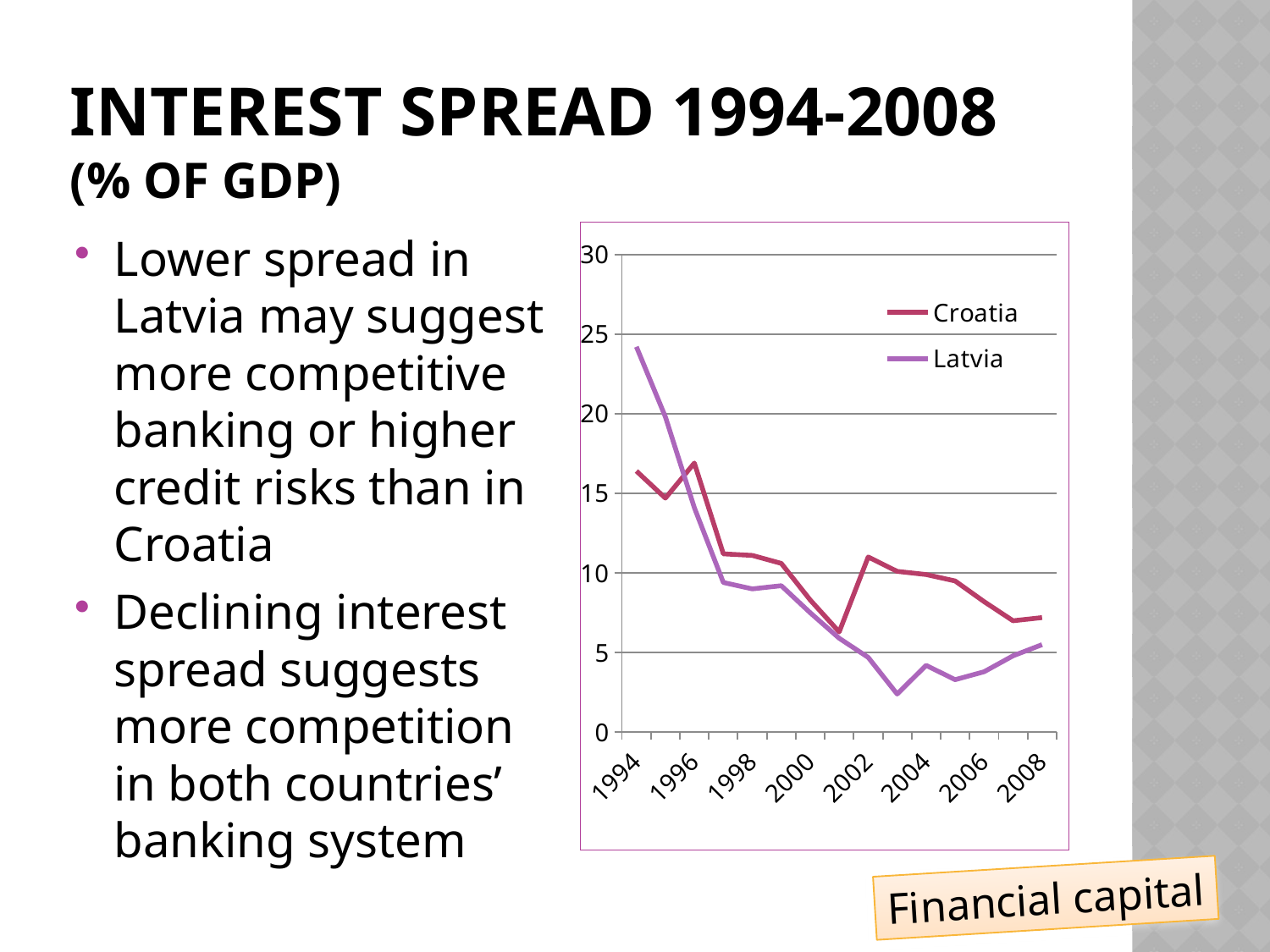
In 2008, which country has the higher interest spread, Croatia or Latvia? Croatia What kind of chart is shown on the slide? line chart How many series does the chart legend list? 2 Is the value for Latvia in 1994 greater or less than 20? greater Is the value for Croatia in 1994 greater or less than 15? greater Is the value for Croatia in 2008 greater or less than 5? greater In 1994, which country has the higher interest spread, Croatia or Latvia? Latvia Does the Latvia line generally rise or fall from 1994 to 2008? fall What colour is the Latvia line in the chart? purple Which two countries are plotted in the chart? Croatia and Latvia